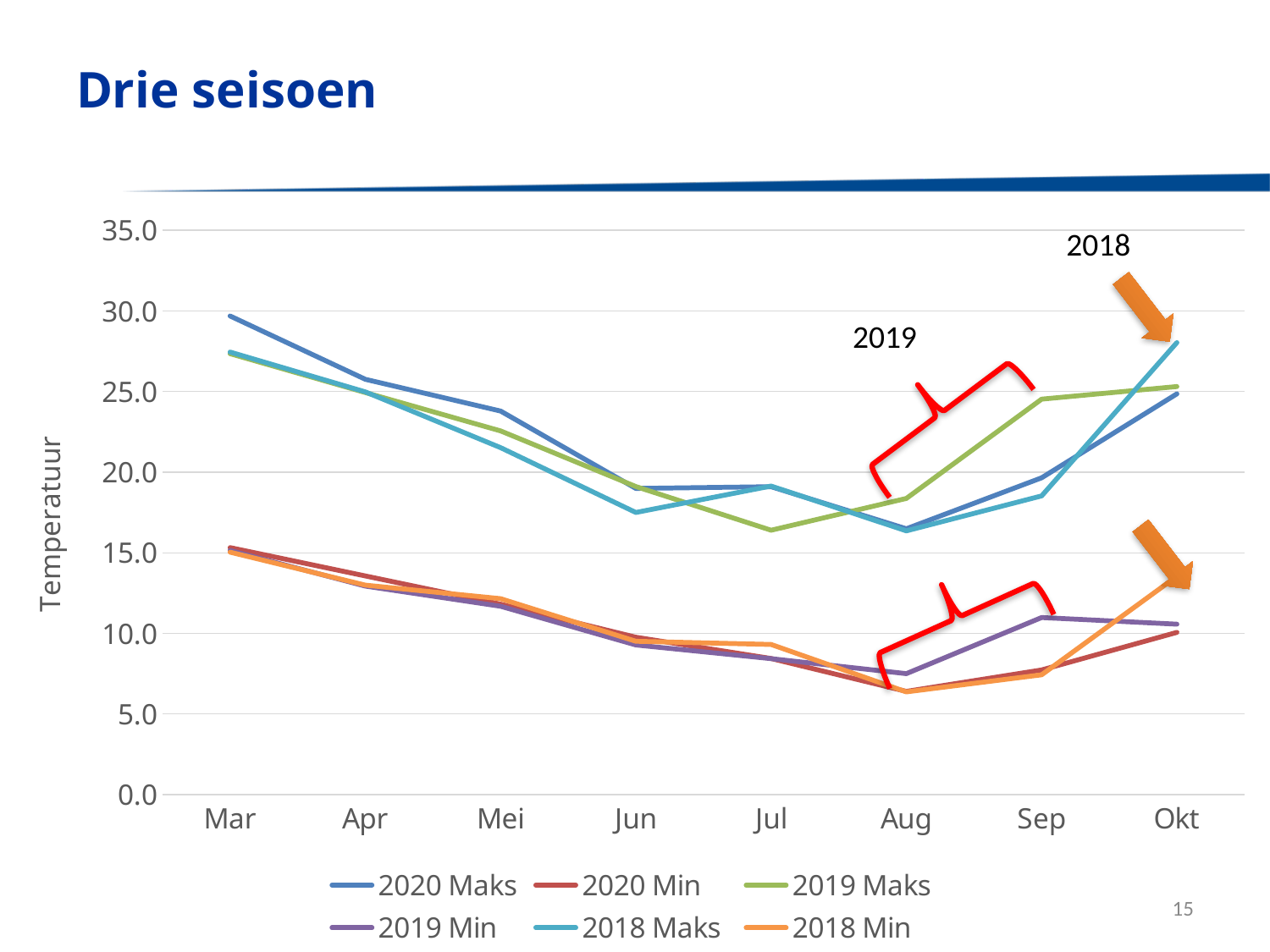
Is the value for 2019 Maks in Jul greater or less than 20.0? less In Okt, which is larger: 2018 Maks or 2020 Maks? 2018 Maks In which month is the 2019 Maks series at its lowest? Jul How many series does the chart's legend list? 6 Is the value for 2020 Maks in Mar greater or less than 25.0? greater In which month is the 2020 Maks series at its highest? Mar What is the label on the vertical axis of the chart? Temperatuur What is the title of the slide containing the chart? Drie seisoen What kind of chart is shown on the slide? line chart Is the value for 2018 Min in Okt greater or less than 10.0? greater How many months are shown on the x axis of the chart? 8